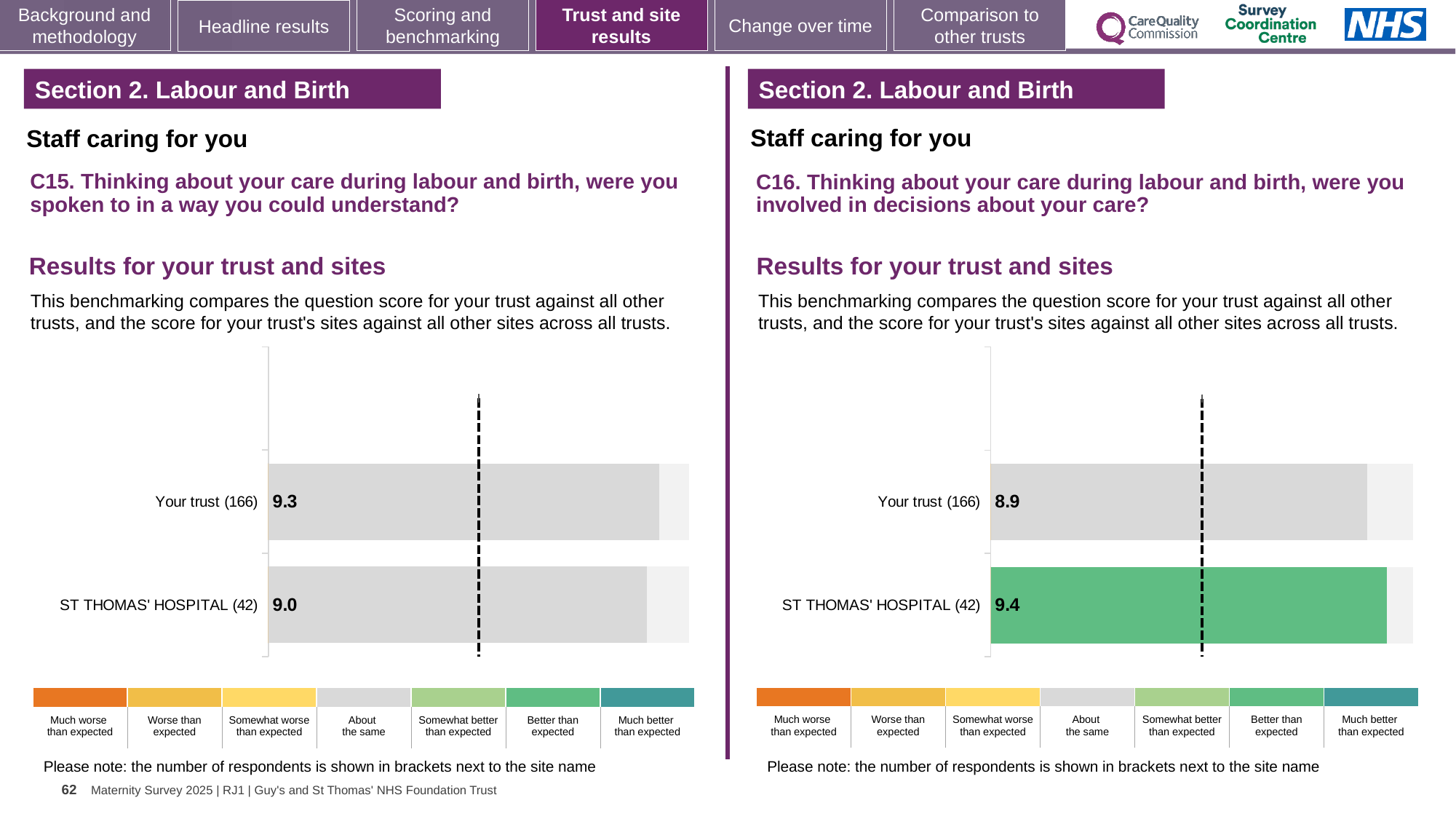
In the C15 chart on the left, which bar has the higher score? Your trust (166) In the C16 chart on the right, what is the difference between the ST THOMAS' HOSPITAL score and the Your trust score? 0.5 In the C15 chart on the left, what is the score for Your trust (166)? 9.3 In the C15 chart on the left, what is the difference between the Your trust score and the ST THOMAS' HOSPITAL score? 0.3 In the C16 chart on the right, which bar has the lower score? Your trust (166) In the C15 chart on the left, what is the score for ST THOMAS' HOSPITAL (42)? 9.0 How many bars are plotted in the C15 chart on the left? 2 In the C16 chart on the right, is the score for ST THOMAS' HOSPITAL (42) larger or smaller than the score for Your trust (166)? larger In the C16 chart on the right, what is the score for Your trust (166)? 8.9 In the C16 chart on the right, what is the score for ST THOMAS' HOSPITAL (42)? 9.4 In the C16 chart on the right, which benchmarking category does the colour of the ST THOMAS' HOSPITAL (42) bar correspond to? Better than expected What kind of chart is used in the C16 chart on the right? bar chart